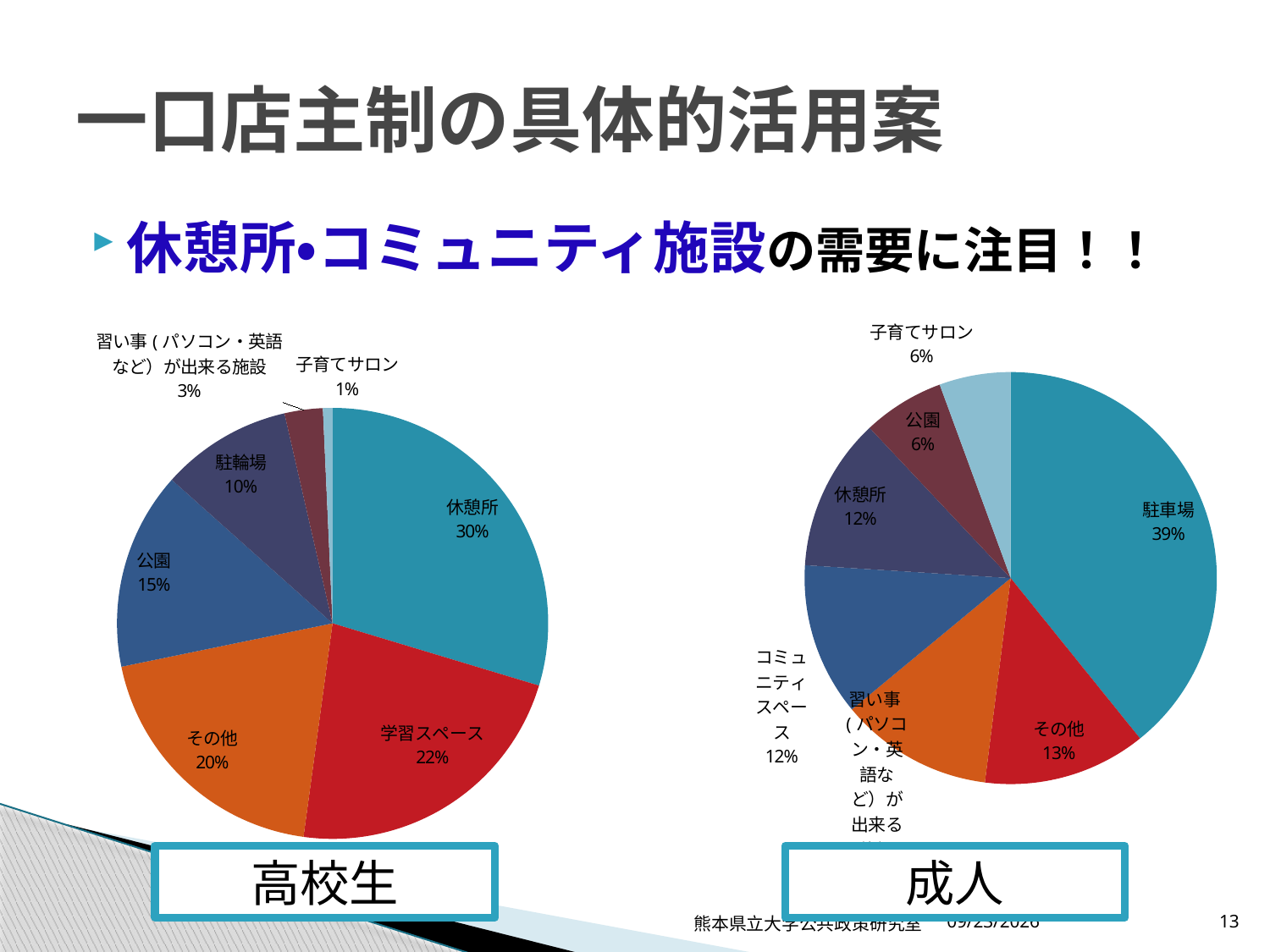
In the 高校生 pie chart, which category has the smallest share? 子育てサロン In the 高校生 pie chart, what percentage is shown for 学習スペース? 22% What type of chart is used on the left side of the slide (高校生)? Pie chart In the 高校生 pie chart, which category has the largest share? 休憩所 In the 成人 pie chart, what percentage is shown for 休憩所? 12% In the 高校生 pie chart, which is larger, その他 or 公園? その他 In the 成人 pie chart, what is the difference in percentage points between 駐車場 and その他? 26 In the 成人 pie chart, which category has the largest share? 駐車場 In the 成人 pie chart, what percentage is shown for 駐車場? 39% In the 高校生 pie chart, what percentage is shown for 休憩所? 30% How many slices does the 高校生 pie chart have? 7 In the 高校生 pie chart, what is the difference in percentage points between 公園 and 駐輪場? 5